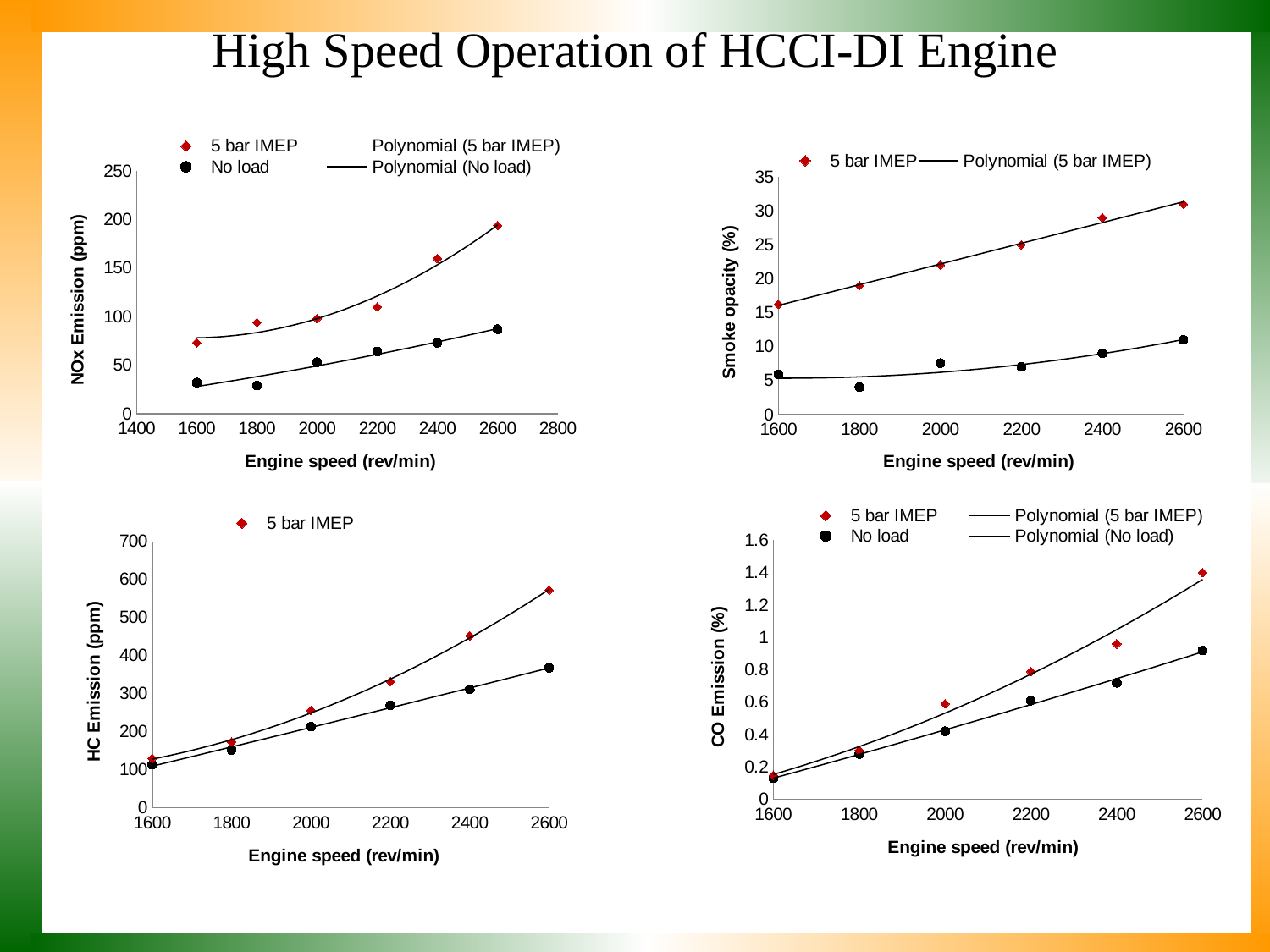
In the HC Emission chart, do the 5 bar IMEP values rise or fall as engine speed increases? rise In the NOx Emission chart, how many engine speed points are plotted for the 5 bar IMEP series? 6 In the NOx Emission chart, is the No load value at 1600 rev/min greater or less than 50? less In the CO Emission chart, is the 5 bar IMEP value at 2600 rev/min greater or less than 1.2? greater How many entries does the legend of the NOx Emission chart list? 4 In the HC Emission chart, at which engine speed is the 5 bar IMEP value lowest? 1600 In the HC Emission chart, at which engine speed is the 5 bar IMEP value highest? 2600 How many entries does the legend of the Smoke opacity chart list? 2 What kind of chart is the NOx Emission chart at the top left? scatter chart What is the x-axis title of the Smoke opacity chart? Engine speed (rev/min) In the Smoke opacity chart, which series has the larger value at 2000 rev/min, 5 bar IMEP or No load? 5 bar IMEP In the NOx Emission chart, is the 5 bar IMEP value at 2600 rev/min greater or less than 150? greater